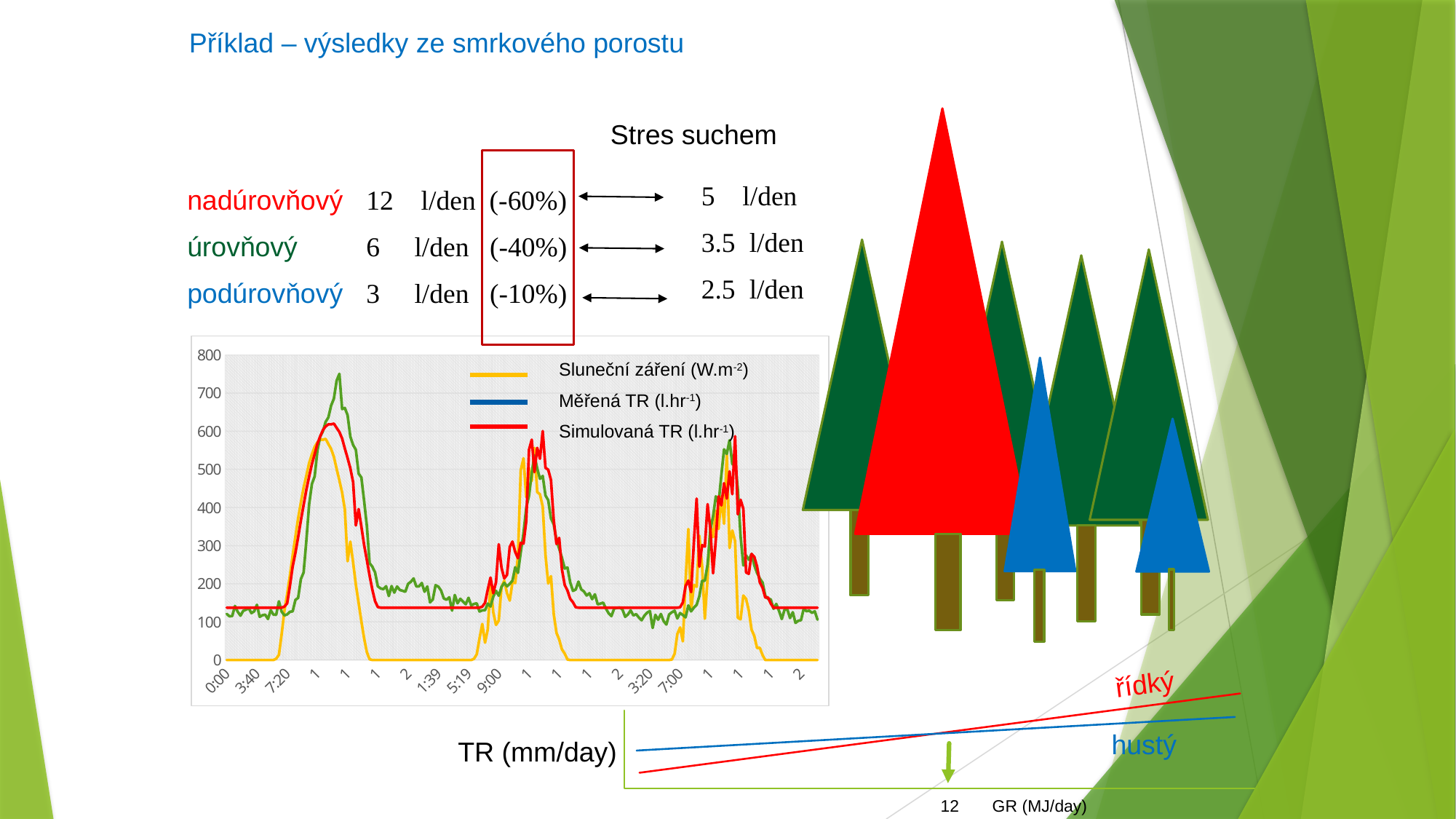
Which series in the chart legend is drawn in yellow? Sluneční záření (W.m-2) Is the lowest value of the yellow Sluneční záření line greater or less than 100? less What is the first label on the chart's horizontal axis? 0:00 Is the first peak of the red Simulovaná TR line greater or less than 500? greater What kind of chart is shown on the slide? line chart Which line reaches a higher value at the first peak, the green line or the yellow Sluneční záření line? the green line How many series does the chart legend list? 3 Does the yellow Sluneční záření line rise or fall immediately after its first peak? fall Which series in the chart legend is drawn in red? Simulovaná TR (l.hr-1) Is the flat baseline of the red Simulovaná TR line between the peaks greater or less than 100? greater What is the highest value shown on the chart's vertical axis? 800